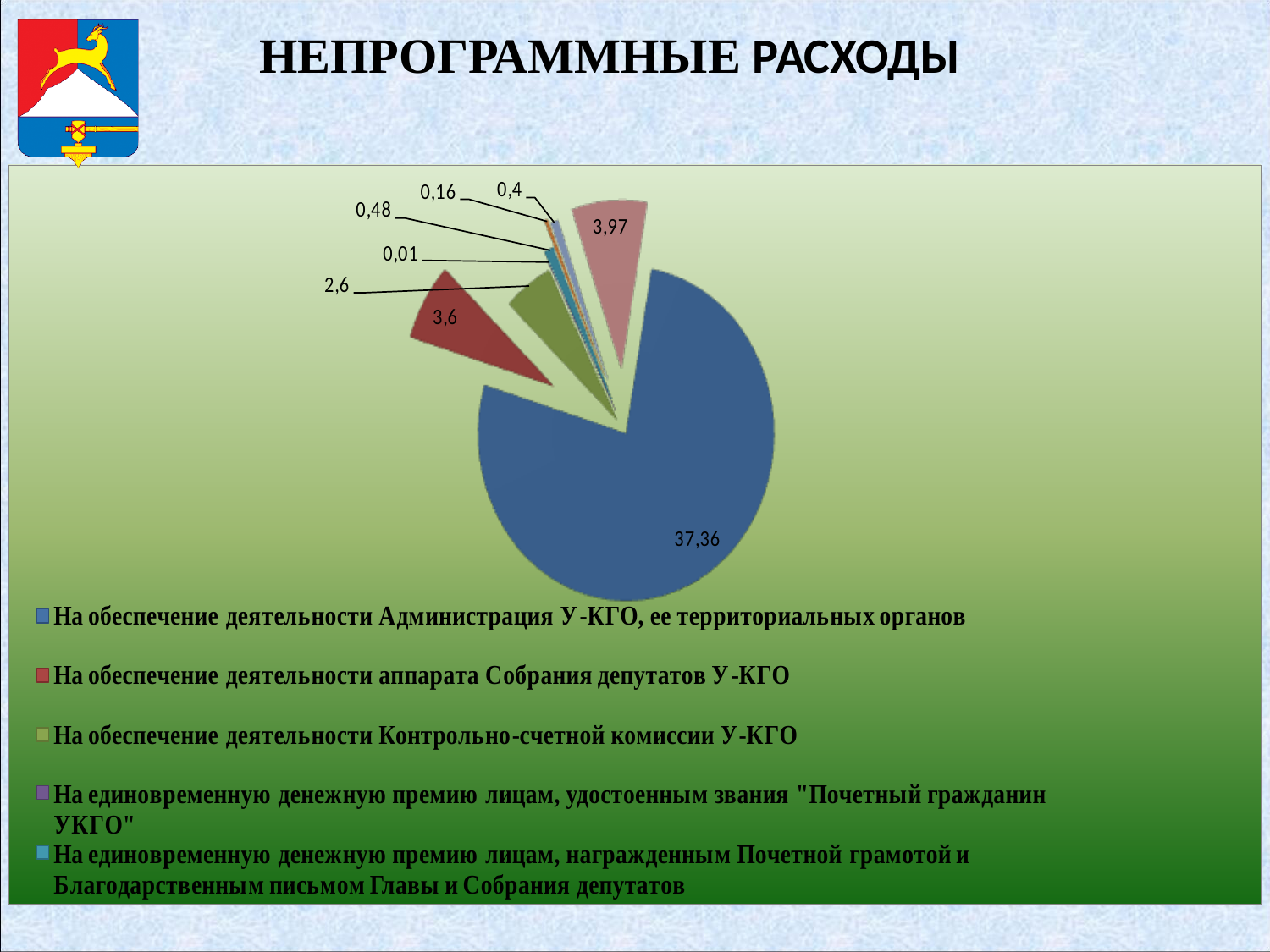
What is the value of the slice for 'На обеспечение деятельности Контрольно-счетной комиссии У-КГО'? 2,6 What is the value of the slice for 'На единовременную денежную премию лицам, удостоенным звания "Почетный гражданин УКГО"'? 0,01 What is the difference between the slice labelled 3,97 and the slice labelled 3,6? 0,37 What is the value of the slice for 'На обеспечение деятельности аппарата Собрания депутатов У-КГО'? 3,6 Which is larger: the slice for аппарата Собрания депутатов У-КГО or the slice for Контрольно-счетной комиссии У-КГО? аппарата Собрания депутатов У-КГО What type of chart is shown on the slide? pie chart What is the value of the slice for 'На обеспечение деятельности Администрация У-КГО, ее территориальных органов'? 37,36 How many slices does the pie chart have? 8 What is the smallest value labelled on the pie chart? 0,01 What is the difference between the slice for Администрация У-КГО (37,36) and the slice for аппарата Собрания депутатов (3,6)? 33,76 Which category has the largest slice of the pie? На обеспечение деятельности Администрация У-КГО, ее территориальных органов What is the title of the slide with the pie chart? НЕПРОГРАММНЫЕ РАСХОДЫ